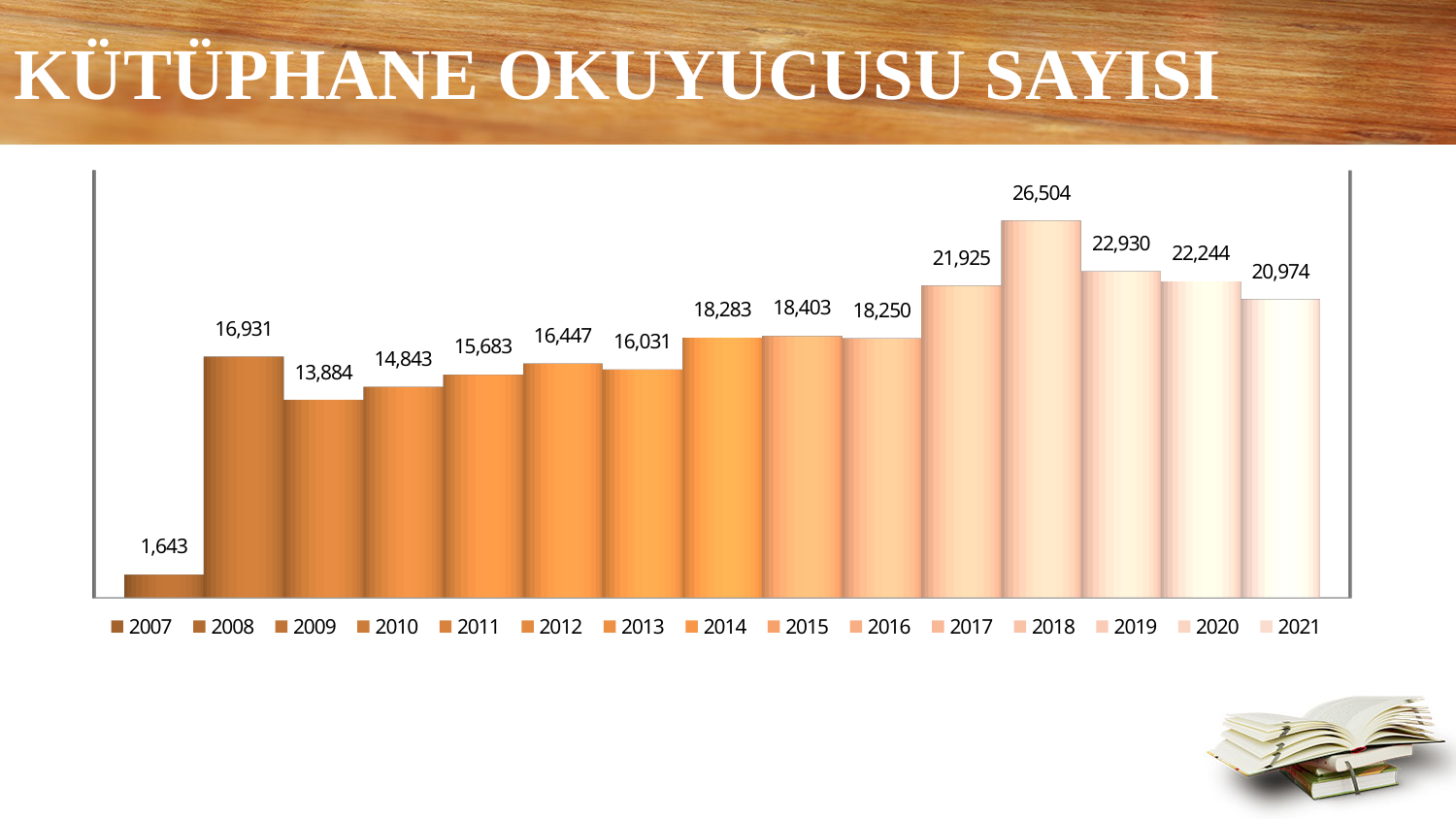
Which is larger, the value for 2008 or the value for 2009? 2008 Which year has the lowest value? 2007 What is the value for 2007? 1,643 Which year has the highest value? 2018 What is the difference between the values for 2018 and 2017? 4,579 What is the value for 2012? 16,447 What is the value for 2018? 26,504 How many years are shown in the chart? 15 What is the difference between the values for 2008 and 2007? 15,288 What is the title of the slide? KÜTÜPHANE OKUYUCUSU SAYISI What kind of chart is shown on the slide? bar chart What is the value for 2021? 20,974